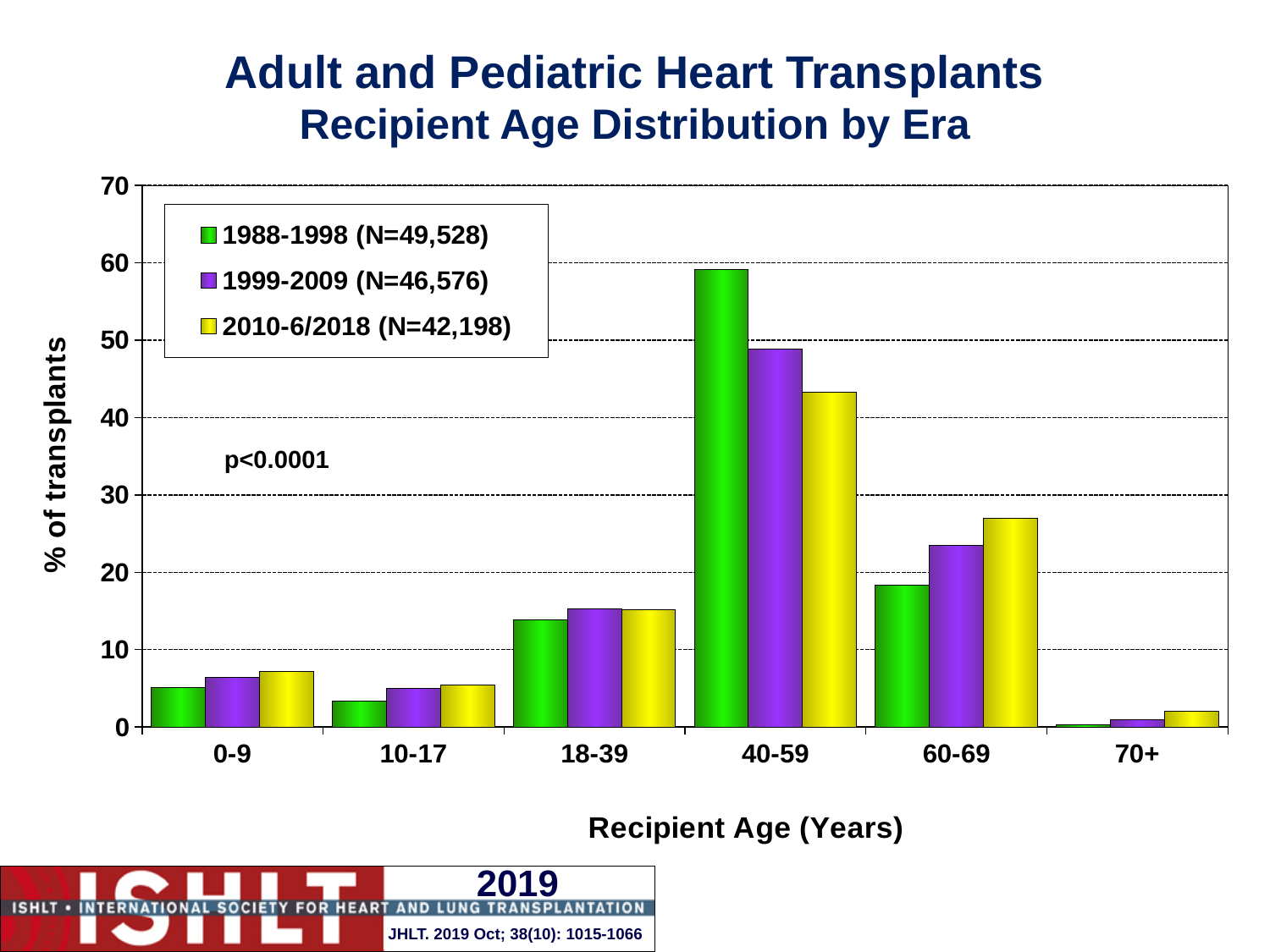
Which recipient age group has the lowest % of transplants for the 2010-6/2018 era? 70+ Is the value for the 40-59 age group in the 1988-1998 era greater or less than 50? greater For the 40-59 age group, which era has the larger % of transplants: 1988-1998 or 1999-2009? 1988-1998 For the 60-69 age group, which era has the larger % of transplants: 1988-1998 or 2010-6/2018? 2010-6/2018 Is the value for the 40-59 age group in the 2010-6/2018 era greater or less than 50? less Which recipient age group has the highest % of transplants for the 1988-1998 era? 40-59 What kind of chart is shown on the slide? bar chart How many recipient age groups are shown on the x axis? 6 Across the three eras in order, does the % of transplants for the 60-69 age group rise or fall? rise Is the value for the 60-69 age group in the 2010-6/2018 era greater or less than 20? greater What is the N shown in the legend for the 1999-2009 era? 46,576 How many series does the legend list? 3